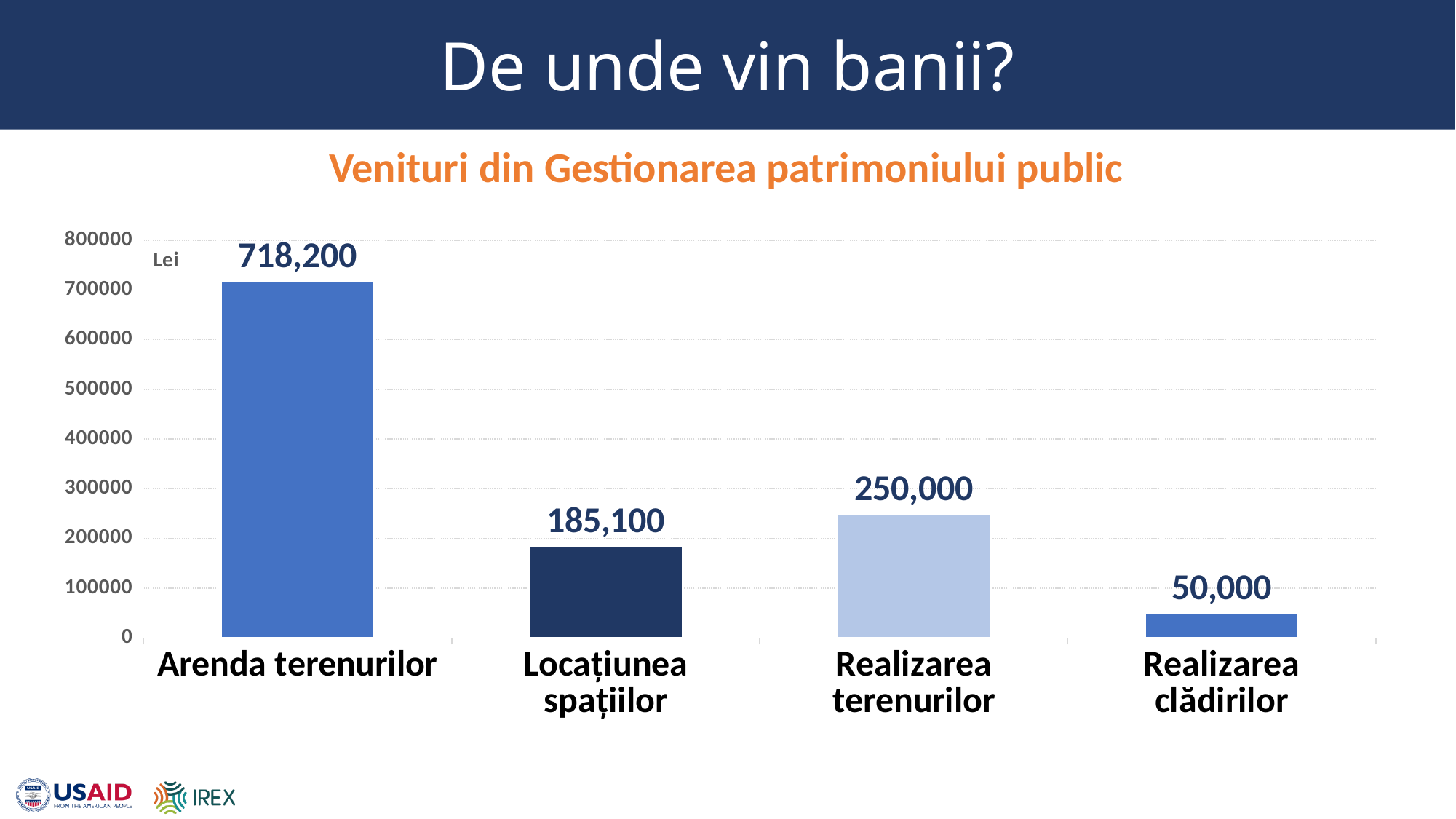
Which category has the highest value? Arenda terenurilor What is the value for Realizarea terenurilor? 250,000 How many categories are shown in the chart? 4 What kind of chart is shown on the slide? Bar chart What is the difference between Realizarea terenurilor and Locațiunea spațiilor? 64,900 What is the title of the chart? Venituri din Gestionarea patrimoniului public What is the value for Locațiunea spațiilor? 185,100 What is the difference between Arenda terenurilor and Realizarea terenurilor? 468,200 What is the value for Realizarea clădirilor? 50,000 What is the value for Arenda terenurilor? 718,200 Which is larger, Locațiunea spațiilor or Realizarea terenurilor? Realizarea terenurilor Which category has the lowest value? Realizarea clădirilor